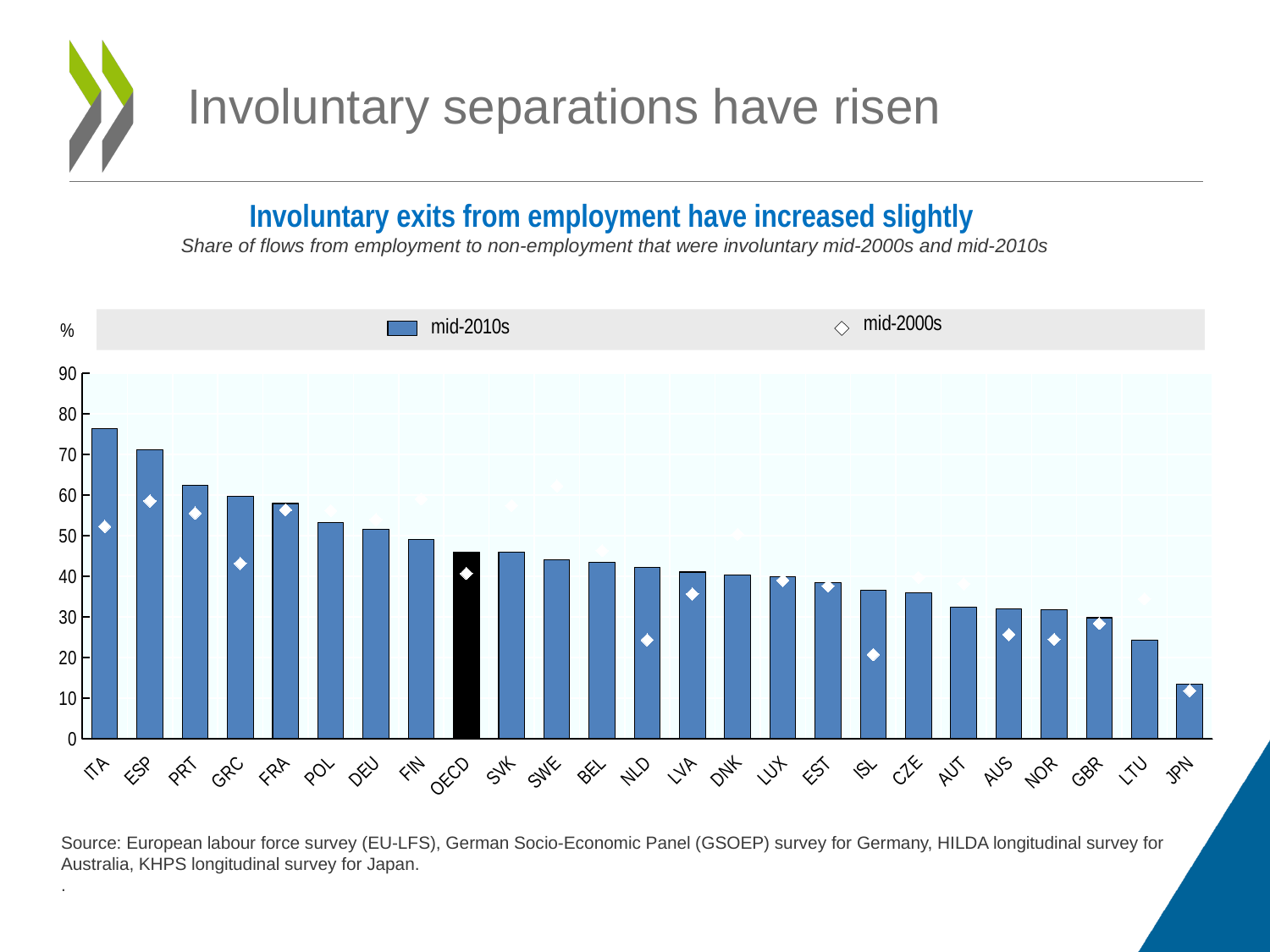
Is the mid-2010s value for ITA greater or less than 70? greater How many countries/categories are shown along the x axis? 25 Which category has the lowest mid-2010s bar? JPN Which category has the highest mid-2010s bar? ITA Is the mid-2010s value for JPN greater or less than 10? greater What kind of chart is shown on the slide? Bar chart Which has the larger mid-2010s bar, NLD or LTU? NLD Do the mid-2010s bars rise or fall moving from left to right along the x axis? Fall Is the mid-2010s value for OECD greater or less than 50? less Which bar is coloured black instead of blue? OECD How many series does the legend list? 2